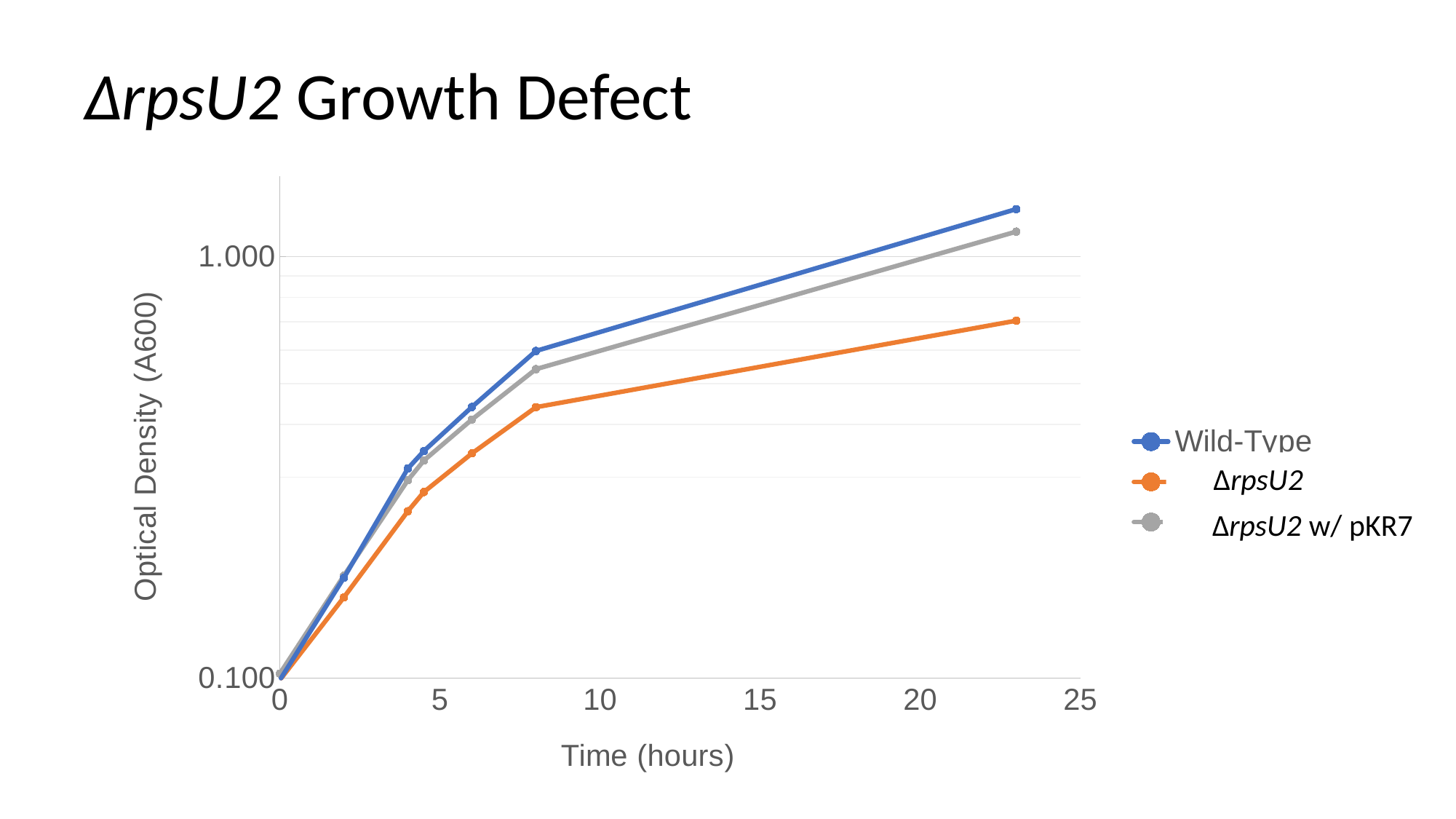
How many series does the legend list? 3 Is the optical density of ΔrpsU2 at 23 hours greater or less than 1.000? less Is the optical density of Wild-Type at 23 hours greater or less than 1.000? greater What kind of chart is shown on the slide? line chart At 8 hours, which has the higher optical density, Wild-Type or ΔrpsU2? Wild-Type Is the optical density of ΔrpsU2 w/ pKR7 at 23 hours greater or less than 1.000? greater Which series has the highest optical density at 23 hours? Wild-Type What is the title of the chart? ΔrpsU2 Growth Defect Do the optical density values rise or fall as time increases? rise Which series has the lowest optical density at 23 hours? ΔrpsU2 What is the label of the x axis? Time (hours)